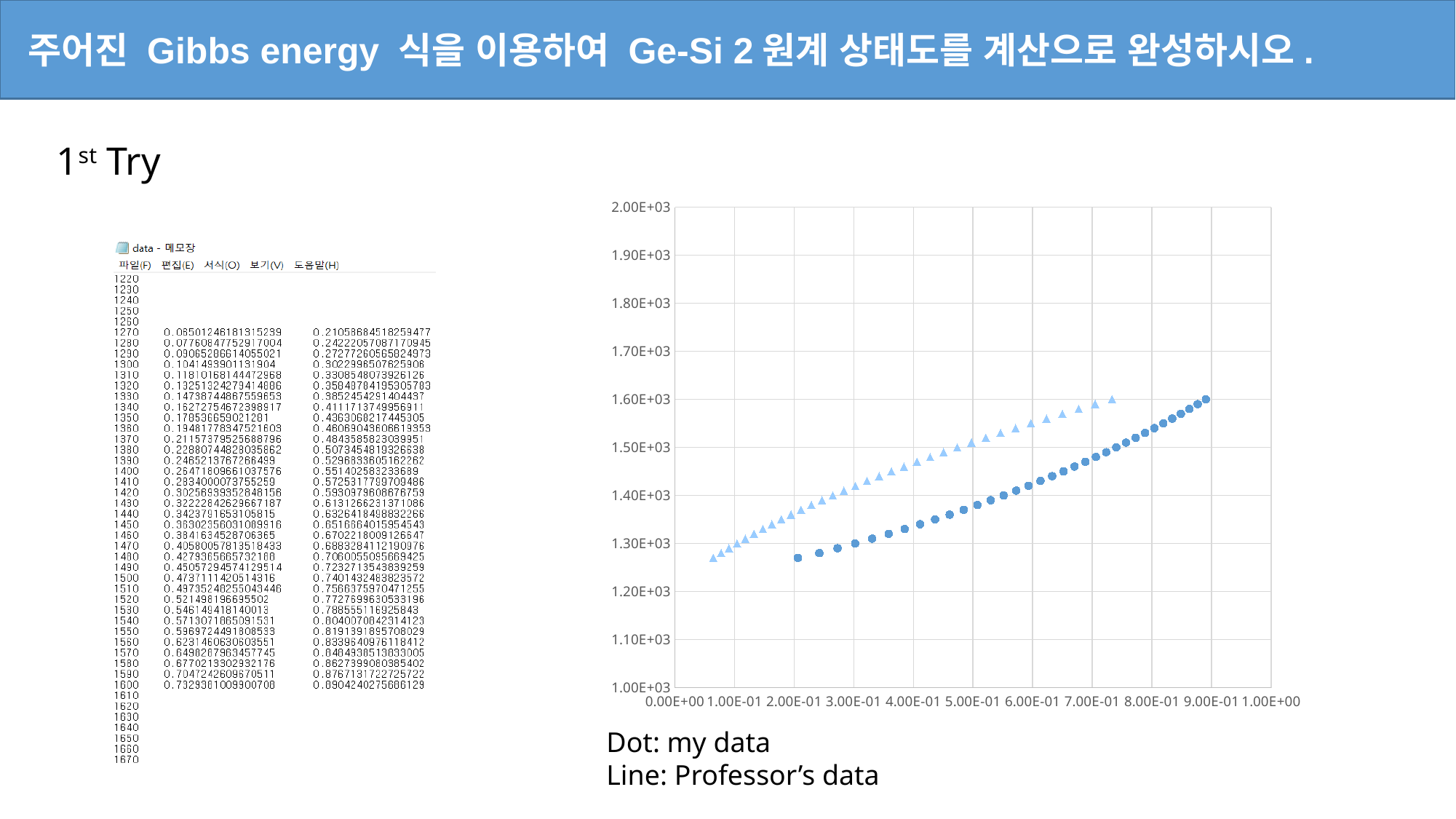
Do the values of the circle (dot) series rise or fall as x increases? rise Is the y value of the circle series at x = 2.00E-01 greater or less than 1.20E+03? greater At x = 5.00E-01, which series has the higher y value, the triangles or the circles? triangles According to the caption below the chart, what do the dots represent? my data Is the y value of the circle series at x = 9.00E-01 greater or less than 1.50E+03? greater Is the highest y value of the triangle series greater or less than 1.70E+03? less How many data series are plotted on the chart? 2 What is the highest tick value shown on the y axis? 2.00E+03 Do the values of the triangle series rise or fall as x increases? rise What kind of chart is shown on the slide? scatter chart